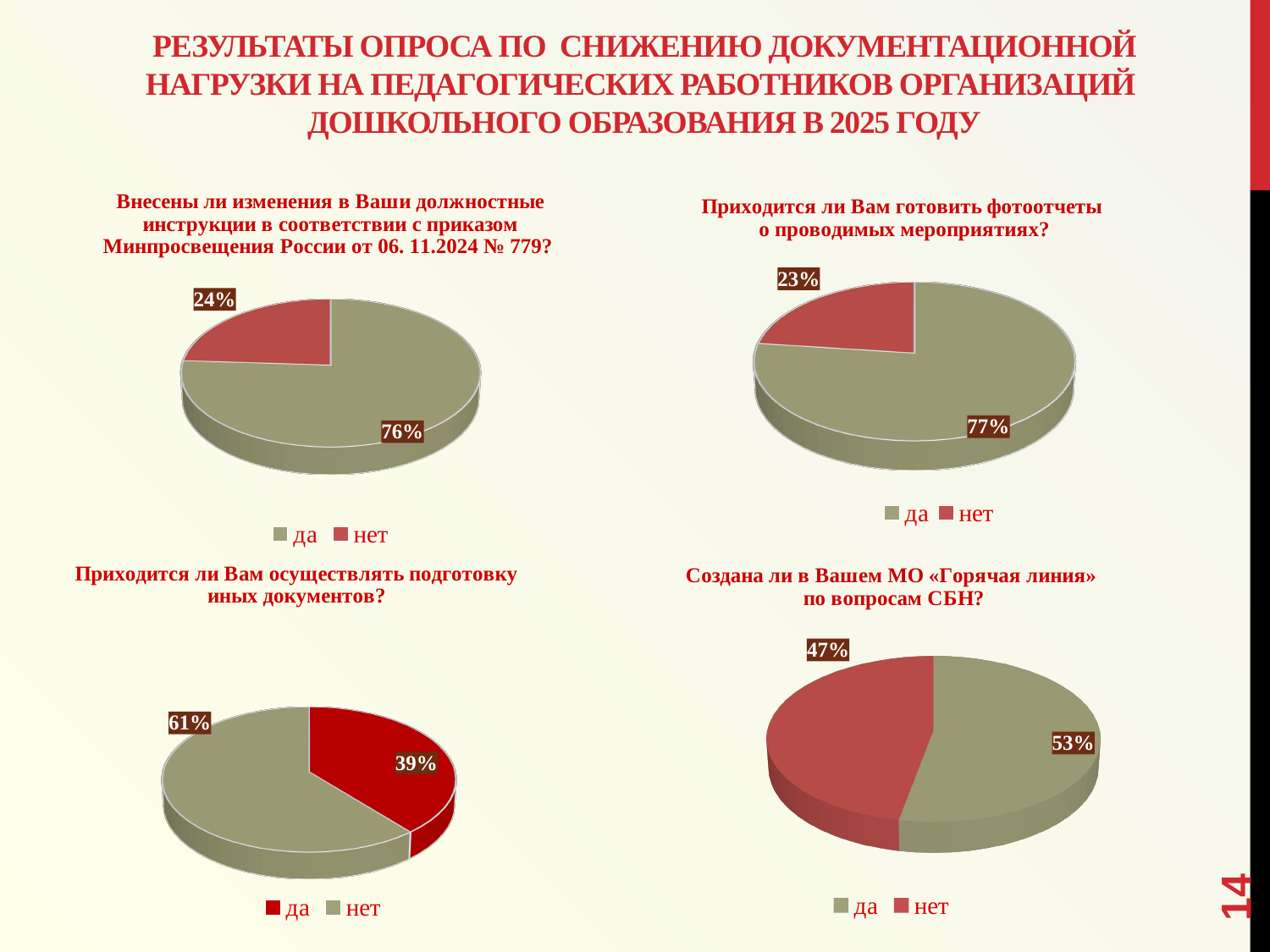
In the chart "Приходится ли Вам готовить фотоотчеты о проводимых мероприятиях?" (top right), what percentage answered "да"? 77% In the chart "Внесены ли изменения в Ваши должностные инструкции..." (top left), what percentage answered "да"? 76% In the chart "Приходится ли Вам осуществлять подготовку иных документов?" (bottom left), what colour represents "да" in the legend? Red In the chart "Приходится ли Вам готовить фотоотчеты о проводимых мероприятиях?" (top right), what is the difference between the "да" and "нет" shares? 54% In the chart "Создана ли в Вашем МО «Горячая линия» по вопросам СБН?" (bottom right), which answer has the smaller share? нет In the chart "Внесены ли изменения в Ваши должностные инструкции..." (top left), what percentage answered "нет"? 24% How many entries does the legend of the top-left chart list? 2 In the chart "Приходится ли Вам осуществлять подготовку иных документов?" (bottom left), which answer has the larger share? нет What type of chart is used for the four survey questions on the slide? Pie chart In the chart "Приходится ли Вам осуществлять подготовку иных документов?" (bottom left), what percentage answered "да"? 39% Is the "да" share in the top-left chart larger or smaller than the "да" share in the top-right chart? Smaller In the chart "Создана ли в Вашем МО «Горячая линия» по вопросам СБН?" (bottom right), what percentage answered "нет"? 47%